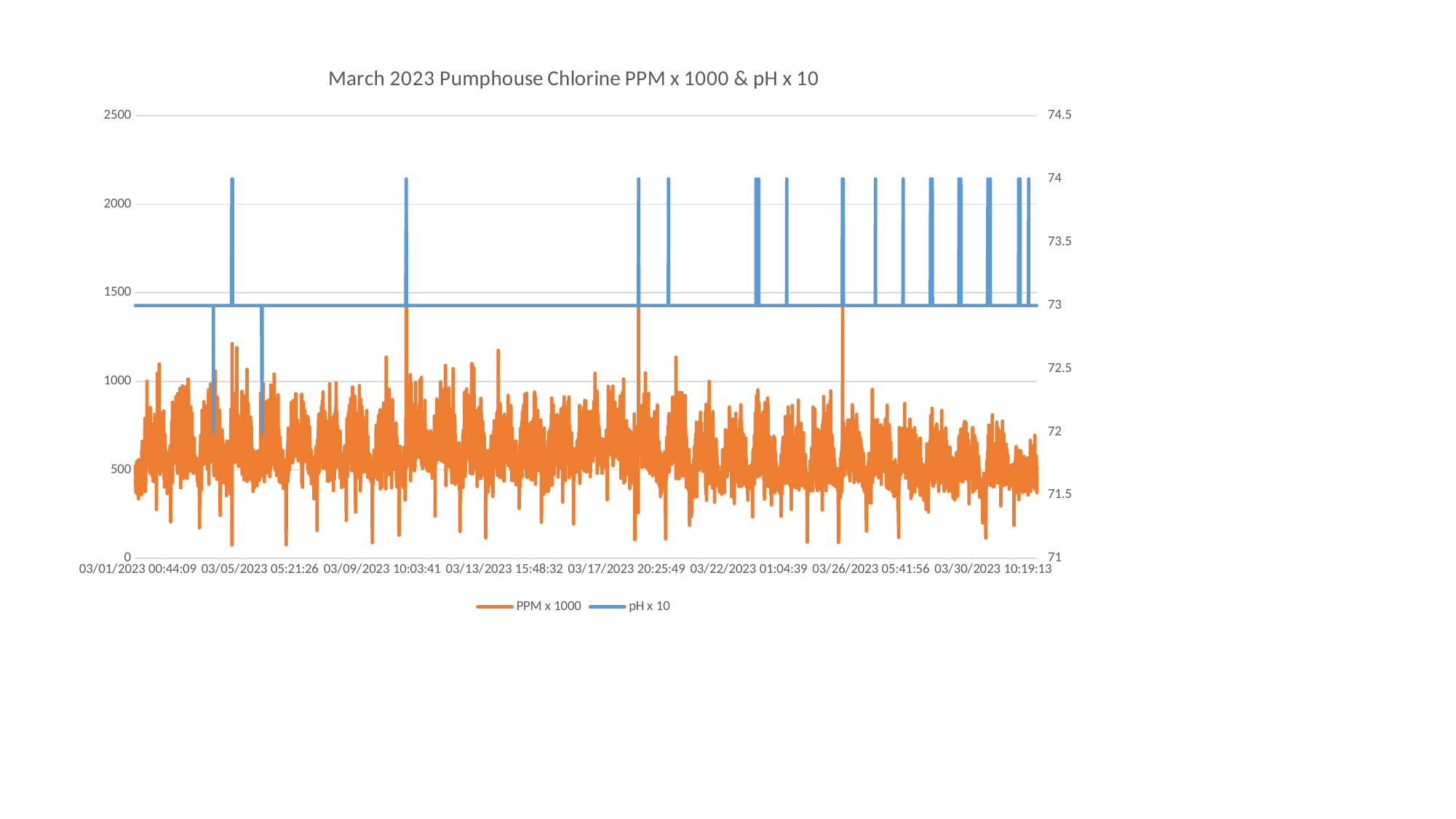
What is the title of the chart? March 2023 Pumphouse Chlorine PPM x 1000 & pH x 10 Which series is drawn in orange? PPM x 1000 Is the highest PPM x 1000 value greater or less than 2000? less On the right axis, what value does the pH x 10 line sit at for most of the month? 73 How many date labels are shown along the x axis? 8 Is the lowest PPM x 1000 value greater or less than 500? less How many series does the legend list? 2 Is the highest pH x 10 value greater or less than 74.5? less What type of chart is shown on the slide? line chart On the right axis, what value do the upward spikes of the pH x 10 line reach? 74 On the right axis, what value do the downward dips of the pH x 10 line around 03/05/2023 reach? 72